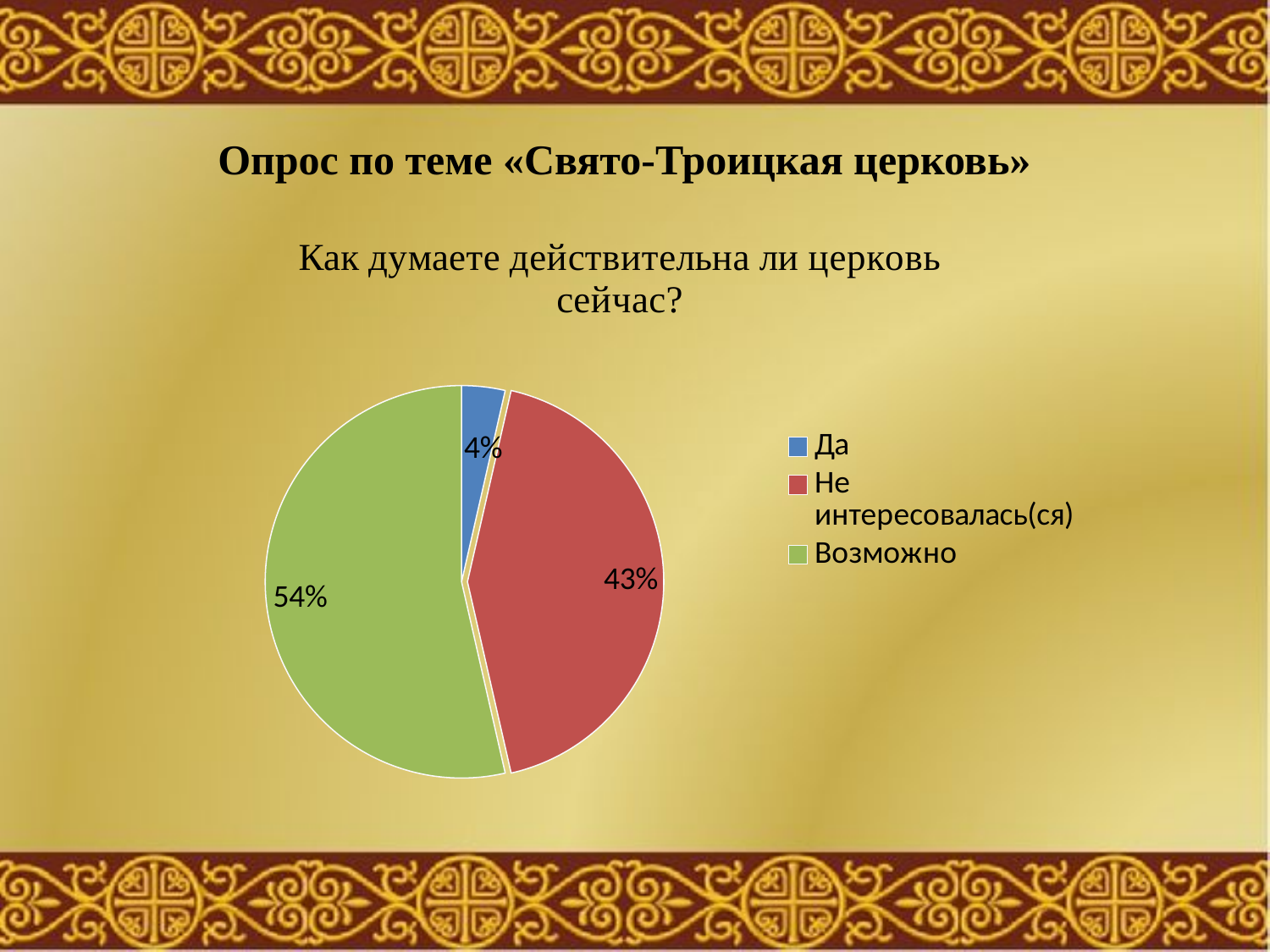
What is the difference between the shares of "Не интересовалась(ся)" and "Да"? 39% How many categories does the pie chart have? 3 Which category has the largest slice of the pie? Возможно What share of the pie does "Да" have? 4% Which category has the smallest slice of the pie? Да Which is larger, the share for "Да" or the share for "Не интересовалась(ся)"? Не интересовалась(ся) What colour is the slice for "Возможно"? green What is the difference between the shares of "Возможно" and "Не интересовалась(ся)"? 11% What share of the pie does "Возможно" have? 54% What share of the pie does "Не интересовалась(ся)" have? 43% What kind of chart is shown on the slide? pie chart What is the title of the chart? Как думаете действительна ли церковь сейчас?